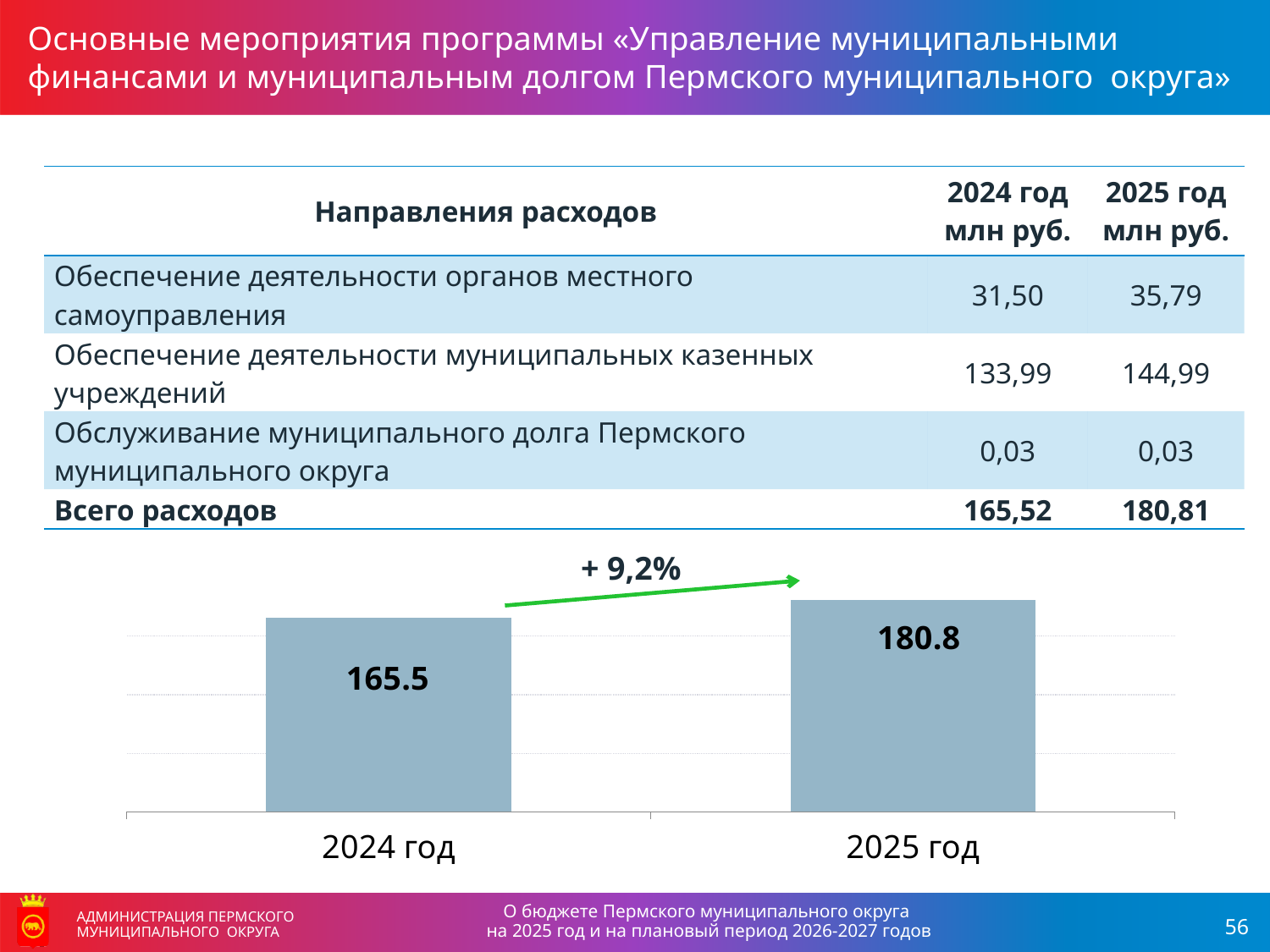
What is the value shown for 2025 год in the bar chart? 180.8 Which year has the highest bar in the chart? 2025 год What is the value shown for 2024 год in the bar chart? 165.5 Which is larger in the bar chart, the value for 2024 год or for 2025 год? 2025 год Which year has the lowest bar in the chart? 2024 год What is the difference between the 2025 год and 2024 год values in the bar chart? 15.3 What percentage change is annotated above the bars in the chart? + 9,2% Do the values in the chart rise or fall from 2024 год to 2025 год? rise What kind of chart is shown on the slide? bar chart What are the category labels on the x axis of the chart? 2024 год, 2025 год How many bars are plotted in the chart? 2